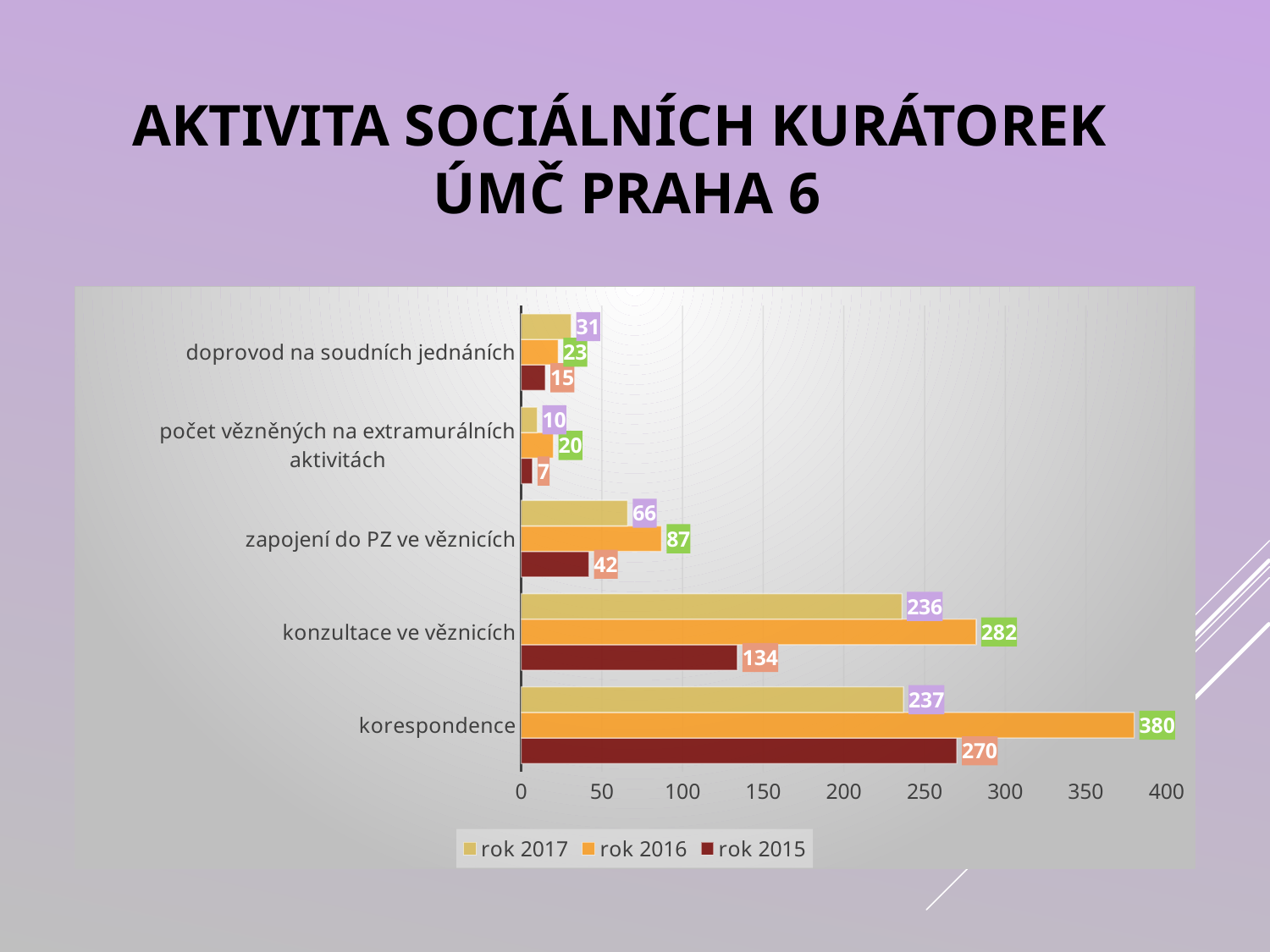
Which category has the lowest value in the rok 2017 series? počet vězněných na extramurálních aktivitách What is the value for zapojení do PZ ve věznicích in the rok 2017 series? 66 What kind of chart is shown on the slide? bar chart What is the value for korespondence in the rok 2016 series? 380 How many categories are shown on the chart? 5 What is the difference between the rok 2016 and rok 2015 values for korespondence? 110 What is the value for počet vězněných na extramurálních aktivitách in the rok 2015 series? 7 Which category has the highest value in the rok 2016 series? korespondence What is the value for konzultace ve věznicích in the rok 2015 series? 134 What is the difference between the rok 2016 and rok 2017 values for konzultace ve věznicích? 46 Which is larger for doprovod na soudních jednáních: the rok 2017 value or the rok 2016 value? rok 2017 How many series does the legend list? 3